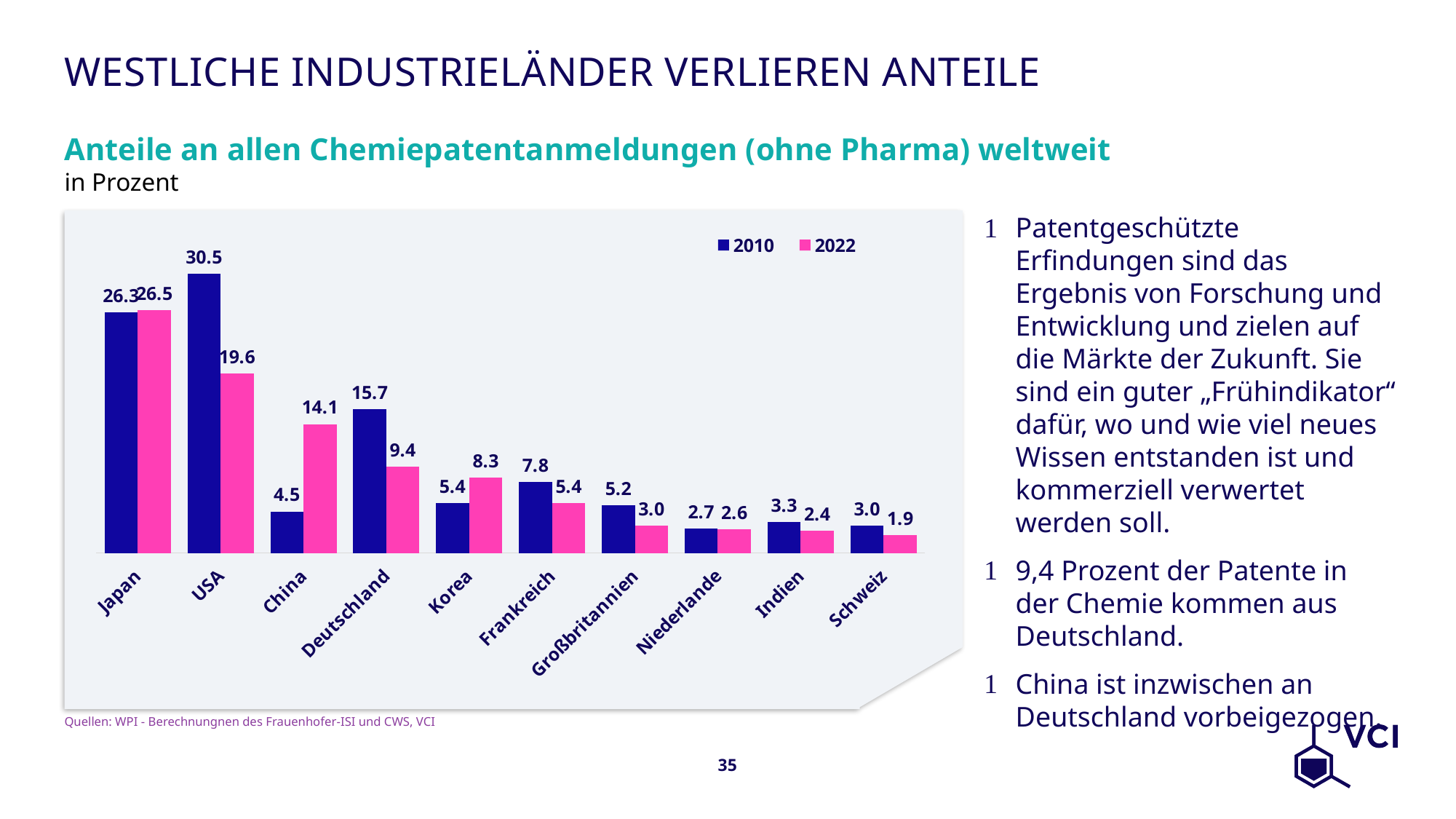
What kind of chart is shown on the slide? Bar chart How many countries are shown on the x axis? 10 What is the difference between the USA's 2010 and 2022 values? 10.9 Which country has the lowest value in 2022? Schweiz Which country has the highest value in 2022? Japan Which is larger: China's 2022 value or Deutschland's 2022 value? China's 2022 value Did Korea's value rise or fall from 2010 to 2022? Rise How many series does the legend list? 2 Which years are listed in the legend? 2010 and 2022 What was the value for Deutschland in 2022? 9.4 What was the value for China in 2022? 14.1 What was the value for USA in 2010? 30.5